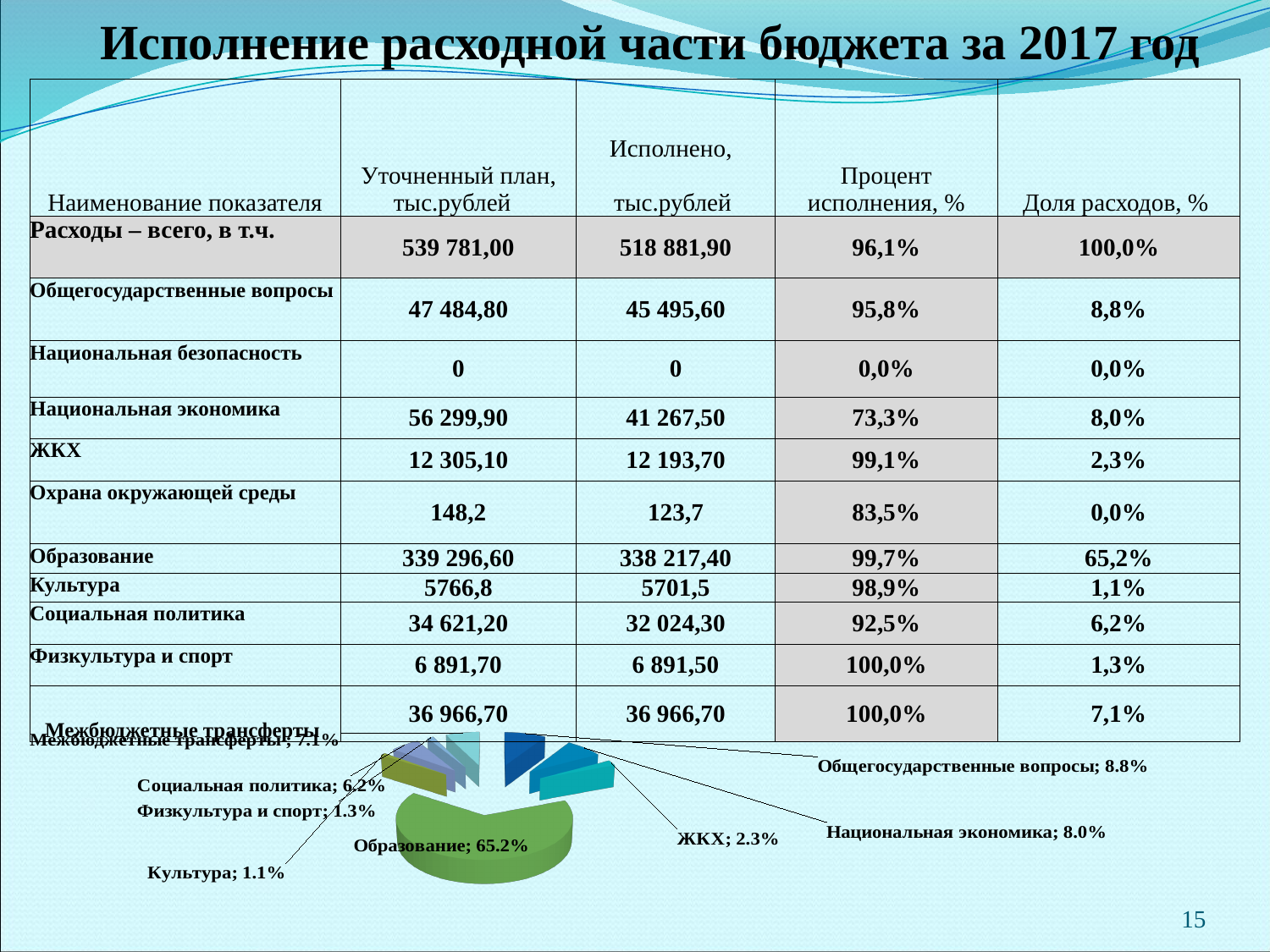
Which slice of the pie chart is the smallest? Культура Which slice of the pie chart is the largest? Образование In the pie chart, what share is shown for Образование? 65.2% In the pie chart, what is the difference between the shares of Общегосударственные вопросы and Национальная экономика? 0.8% In the pie chart, what share is shown for ЖКХ? 2.3% In the pie chart, what share is shown for Культура? 1.1% In the pie chart, what share is shown for Межбюджетные трансферты? 7.1% In the pie chart, what share is shown for Национальная экономика? 8.0% In the pie chart, which is larger: Социальная политика or Физкультура и спорт? Социальная политика What kind of chart is shown at the bottom of the slide? pie chart How many labeled slices does the pie chart have? 8 In the pie chart, what share is shown for Общегосударственные вопросы? 8.8%